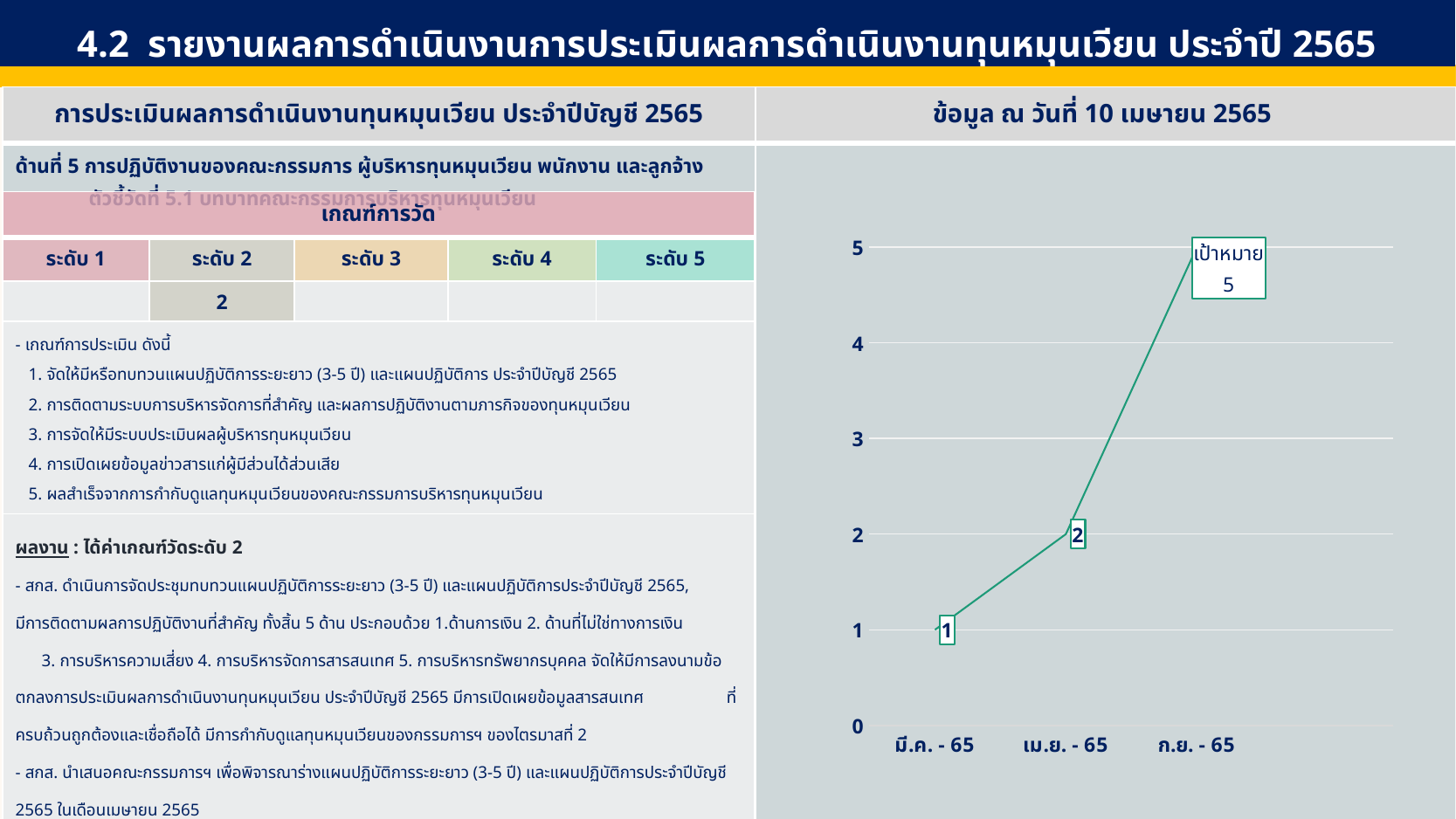
How many data points are plotted on the line chart? 3 Which x-axis category has the lowest value? มี.ค. - 65 Do the values rise or fall from มี.ค. - 65 to ก.ย. - 65? rise What is the value plotted for ก.ย. - 65? 5 What is the difference between the value for ก.ย. - 65 and the value for เม.ย. - 65? 3 What kind of chart is shown on the right side of the slide? line chart What is the value plotted for เม.ย. - 65? 2 What is the value plotted for มี.ค. - 65? 1 Which x-axis category has the highest value? ก.ย. - 65 Which is larger, the value for เม.ย. - 65 or the value for มี.ค. - 65? เม.ย. - 65 What is the difference between the value for เม.ย. - 65 and the value for มี.ค. - 65? 1 What label is attached to the data point for ก.ย. - 65? เป้าหมาย 5